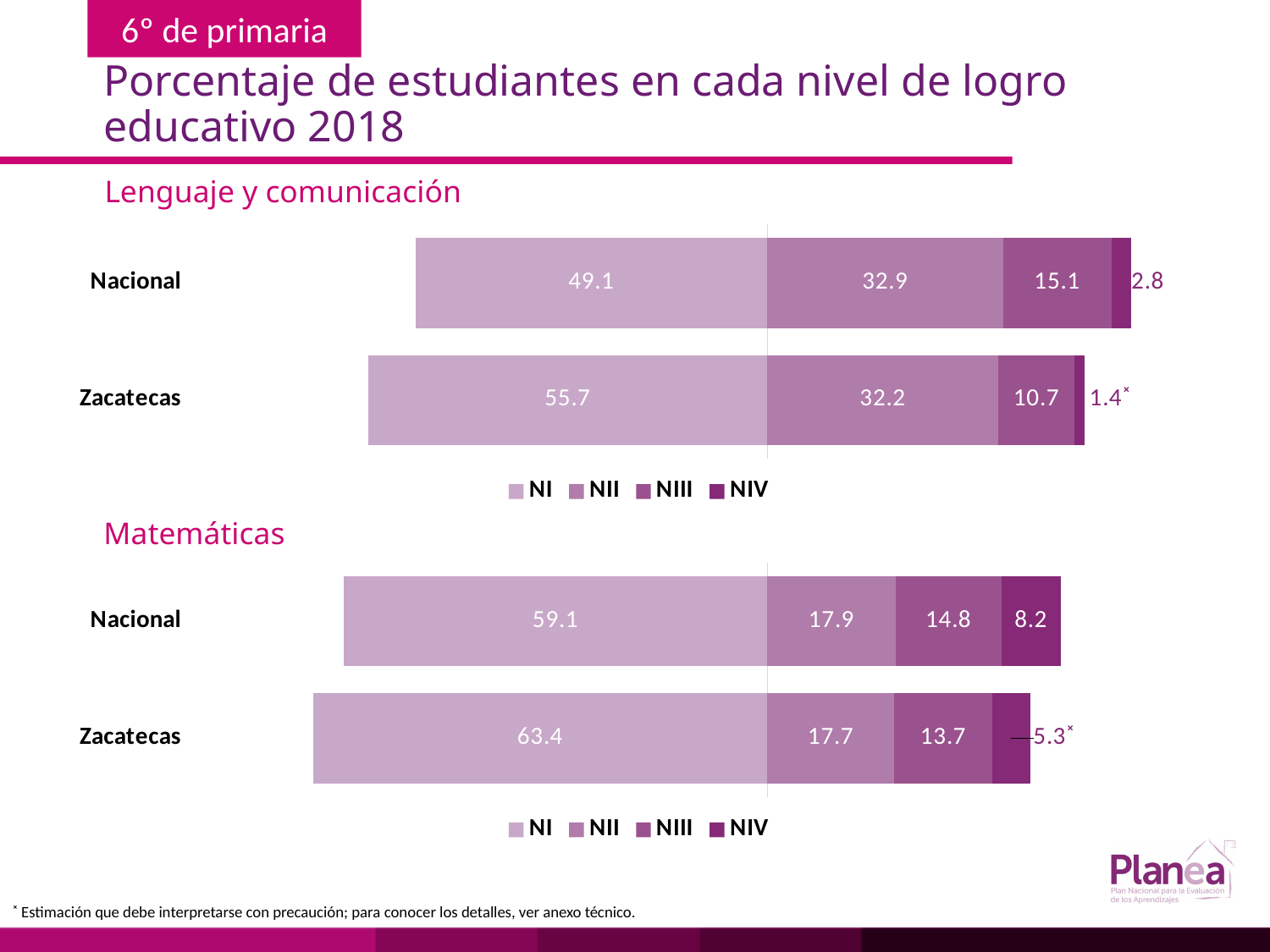
In the Matemáticas chart, what is the NII value for Zacatecas? 17.7 In the Matemáticas chart, what is the total of the stacked bar for Nacional? 100.0 In the Lenguaje y comunicación chart, what is the NI value for Zacatecas? 55.7 In the Matemáticas chart, what is the NIV value for Nacional? 8.2 How many series does the legend of the Lenguaje y comunicación chart list? 4 What type of chart is the Matemáticas chart? Stacked bar chart In the Lenguaje y comunicación chart, what is the difference between the NI values for Zacatecas and Nacional? 6.6 In the Matemáticas chart, which level has the highest value for Zacatecas? NI In the Matemáticas chart, what is the difference between the NIV values for Nacional and Zacatecas? 2.9 In the Matemáticas chart, which is larger, the NIII value for Nacional or for Zacatecas? Nacional In the Lenguaje y comunicación chart, what is the NIII value for Nacional? 15.1 In the Lenguaje y comunicación chart, which level has the lowest value for Nacional? NIV